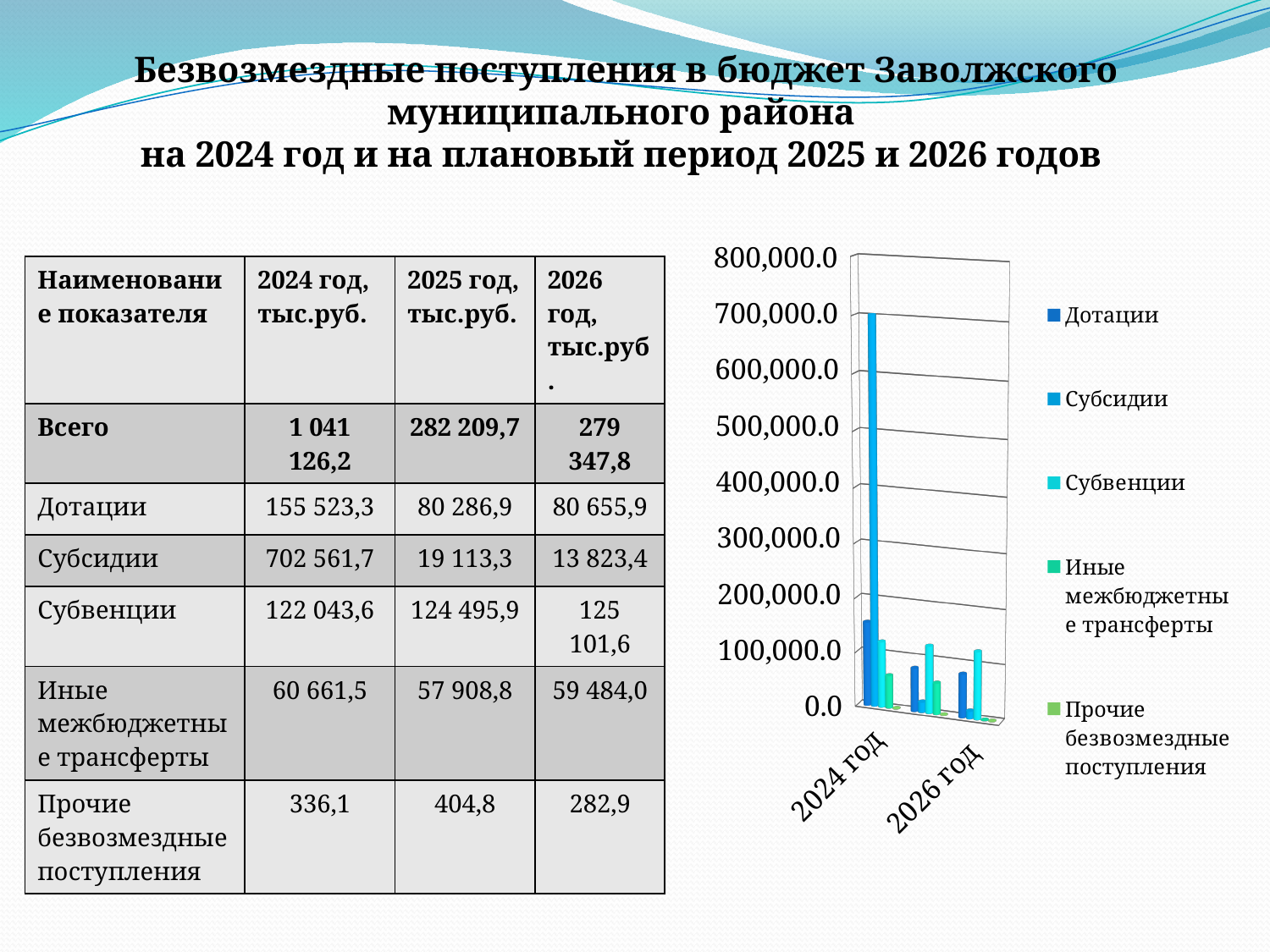
What kind of chart is shown on the right of the slide? bar chart By how much does Дотации in 2024 год exceed Дотации in 2025 год, according to the table? 75 236,4 Which series has the shortest bar for 2024 год in the chart? Прочие безвозмездные поступления Which series is shown in the lightest green colour in the chart legend? Прочие безвозмездные поступления Do the values for Субсидии rise or fall from 2024 год to 2026 год? fall How many series does the chart legend list? 5 According to the table, what is the value of Субсидии for 2024 год, тыс.руб.? 702 561,7 Which series has the tallest bar for 2024 год in the chart? Субсидии Is the value for Субсидии in 2024 год greater or less than 600,000.0? greater Is the value for Дотации in 2024 год greater or less than 200,000.0? less Which is larger in 2026 год: Дотации or Субвенции? Субвенции According to the table, what is the value of Всего for 2025 год, тыс.руб.? 282 209,7